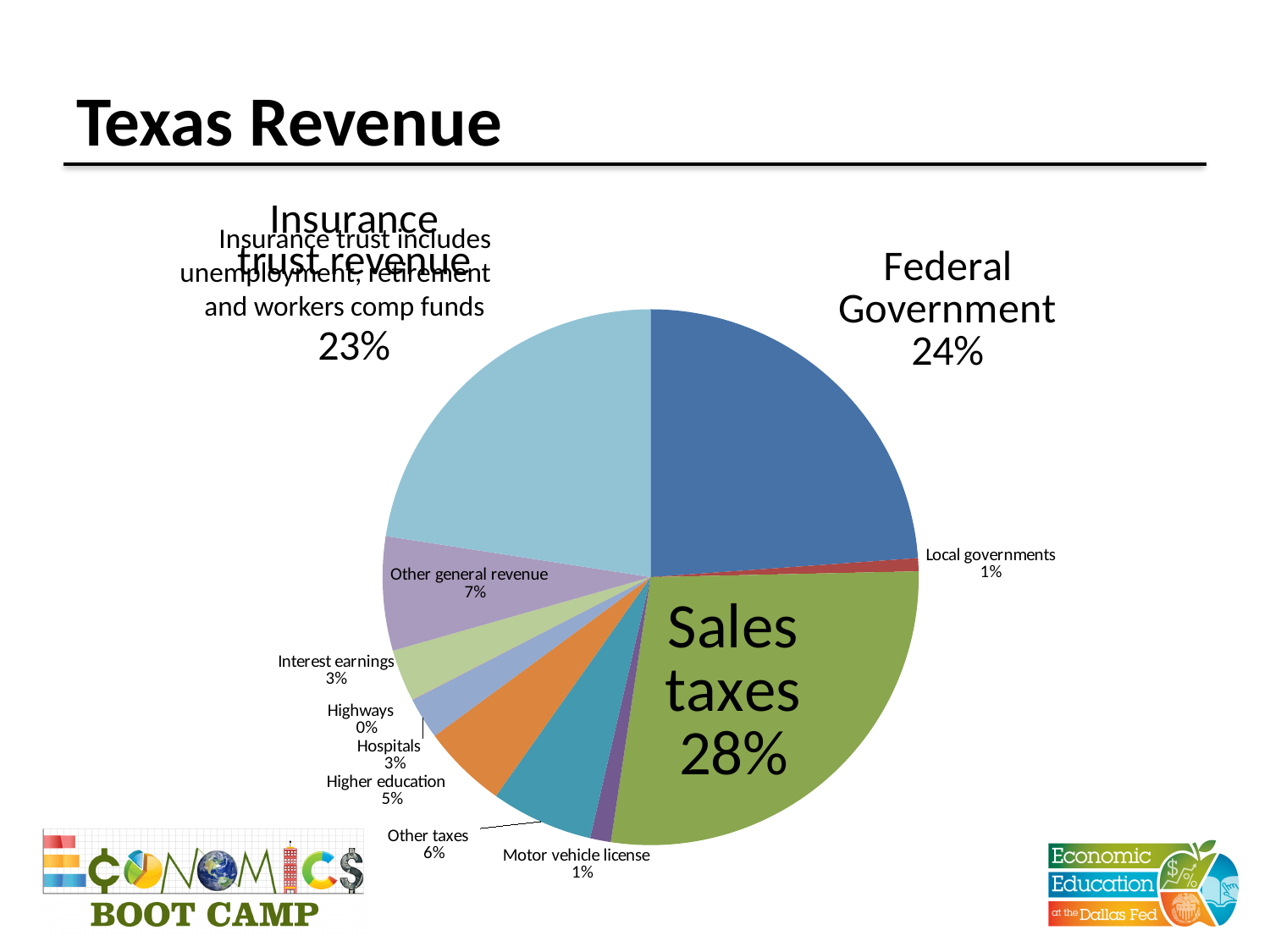
What kind of chart is shown on the slide? Pie chart Which category has the smallest share of Texas revenue? Highways What is the title of the chart on the slide? Texas Revenue How many categories are shown in the pie chart? 11 Which is larger, the share for Federal Government or the share for Insurance trust revenue? Federal Government What share of Texas revenue comes from the Federal Government? 24% Which category has the largest share of Texas revenue? Sales taxes What share of Texas revenue comes from Insurance trust revenue? 23% How many percentage points larger is the Sales taxes share than the Federal Government share? 4 percentage points What percentage is shown for Other general revenue? 7% What percentage is shown for Higher education? 5% What percentage is shown for Other taxes? 6%